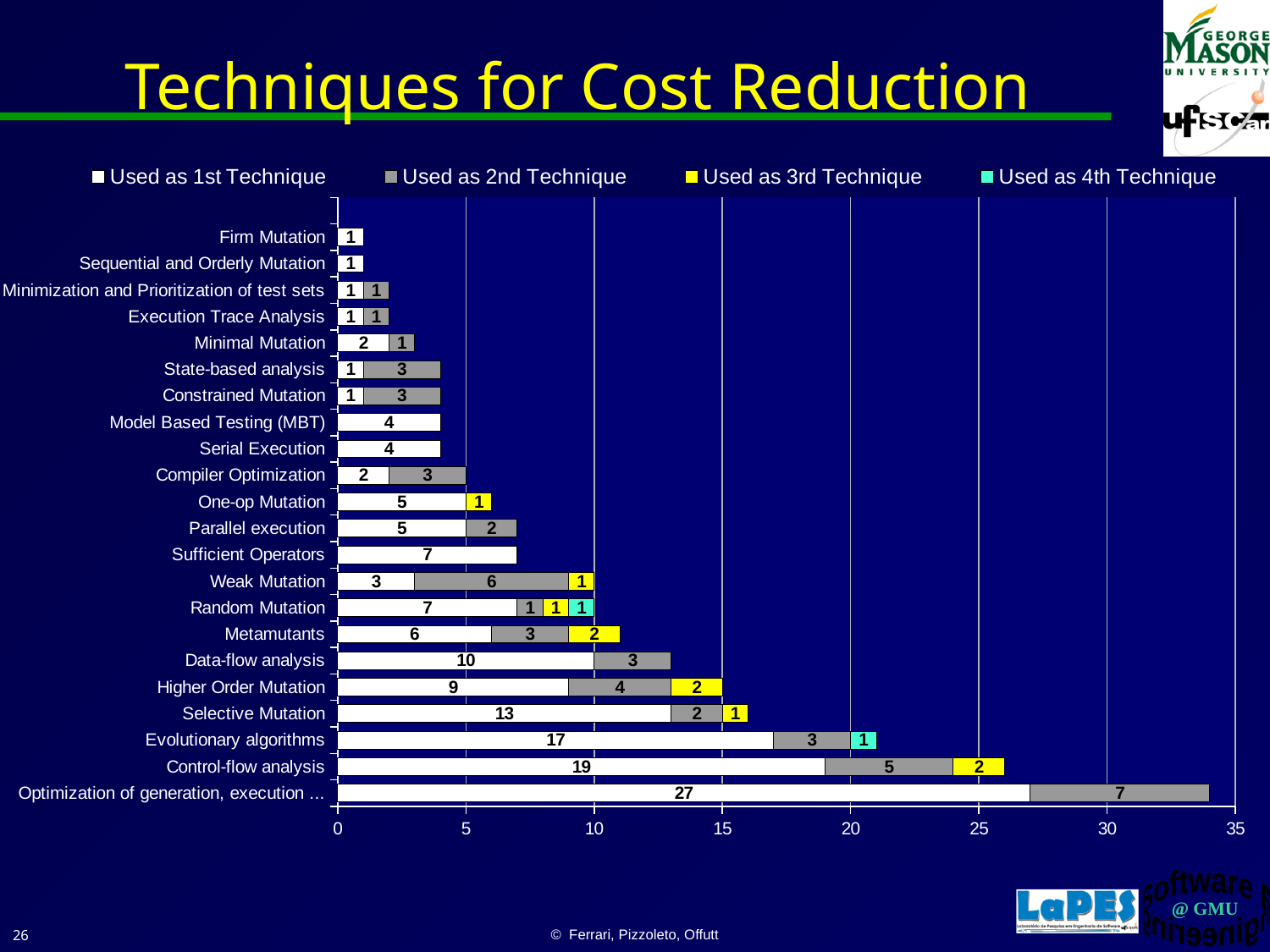
How many techniques (categories) are plotted on the chart? 22 What is the 'Used as 4th Technique' value for Random Mutation? 1 What is the total of the stacked bar for Control-flow analysis? 26 What colour represents 'Used as 3rd Technique' in the legend? yellow What is the 'Used as 2nd Technique' value for Higher Order Mutation? 4 What kind of chart is shown on the slide? bar chart Which has the larger 'Used as 2nd Technique' value, Weak Mutation or Metamutants? Weak Mutation What is the total of the stacked bar for Evolutionary algorithms? 21 What is the difference between the 'Used as 1st Technique' values for Selective Mutation and Data-flow analysis? 3 How many series does the legend list? 4 Which technique has the longest total bar? Optimization of generation, execution ... What is the 'Used as 1st Technique' value for Control-flow analysis? 19